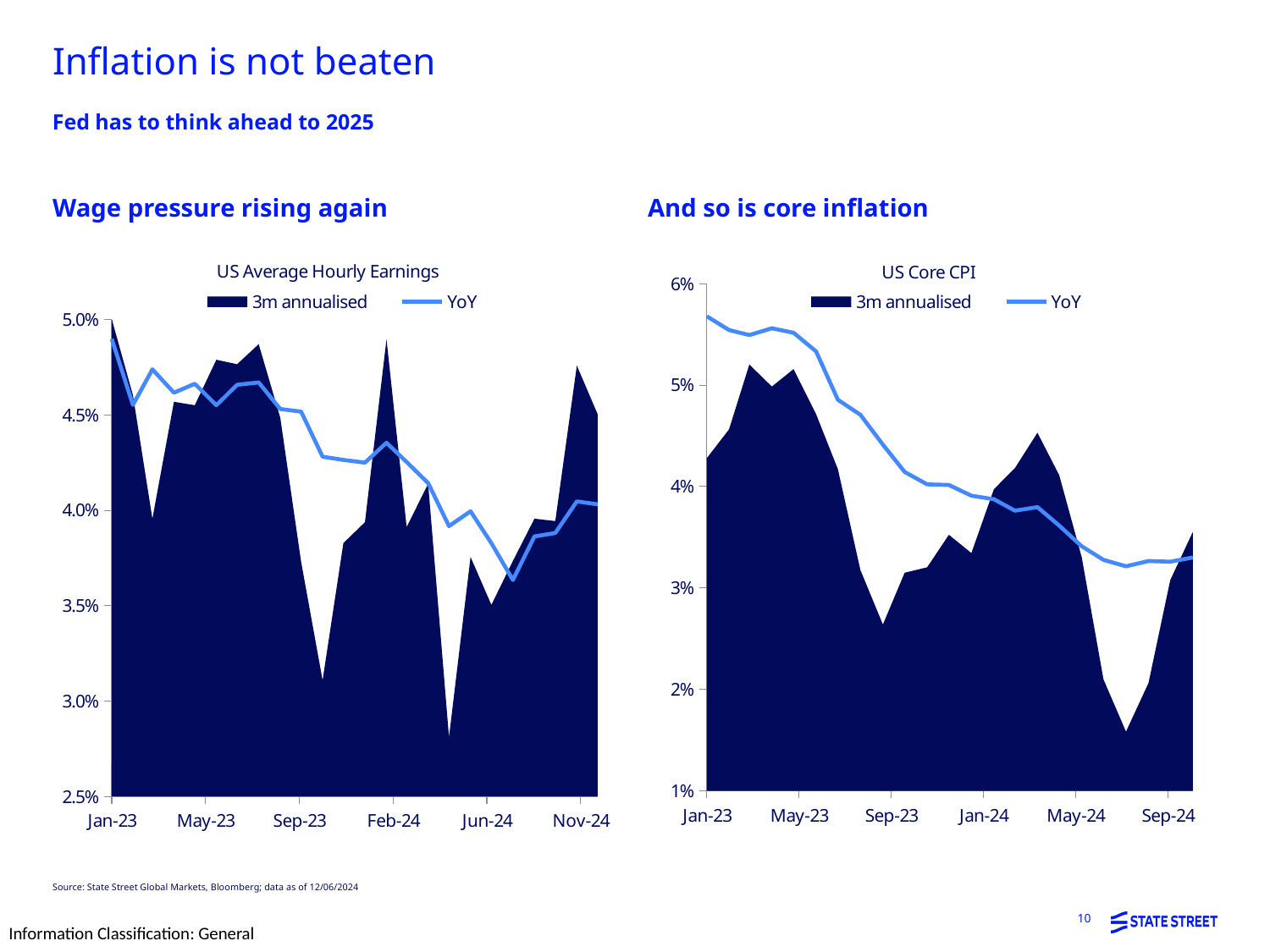
In the US Core CPI chart, which series is drawn as a filled area rather than a line? 3m annualised In the US Average Hourly Earnings chart, how many series does the legend list? 2 In the US Core CPI chart, is the lowest point of the 3m annualised series greater or less than 2%? less In the US Core CPI chart, is the YoY value at Sep-24 greater or less than 3%? greater What is the title of the chart on the right of the slide? US Core CPI In the US Core CPI chart, is the YoY value at Jan-23 greater or less than 5%? greater In the US Core CPI chart, does the YoY series rise or fall overall from Jan-23 to Sep-24? fall In the US Core CPI chart, how many series does the legend list? 2 In the US Average Hourly Earnings chart, does the YoY series rise or fall overall from Jan-23 to Nov-24? fall What is the title of the chart on the left of the slide? US Average Hourly Earnings